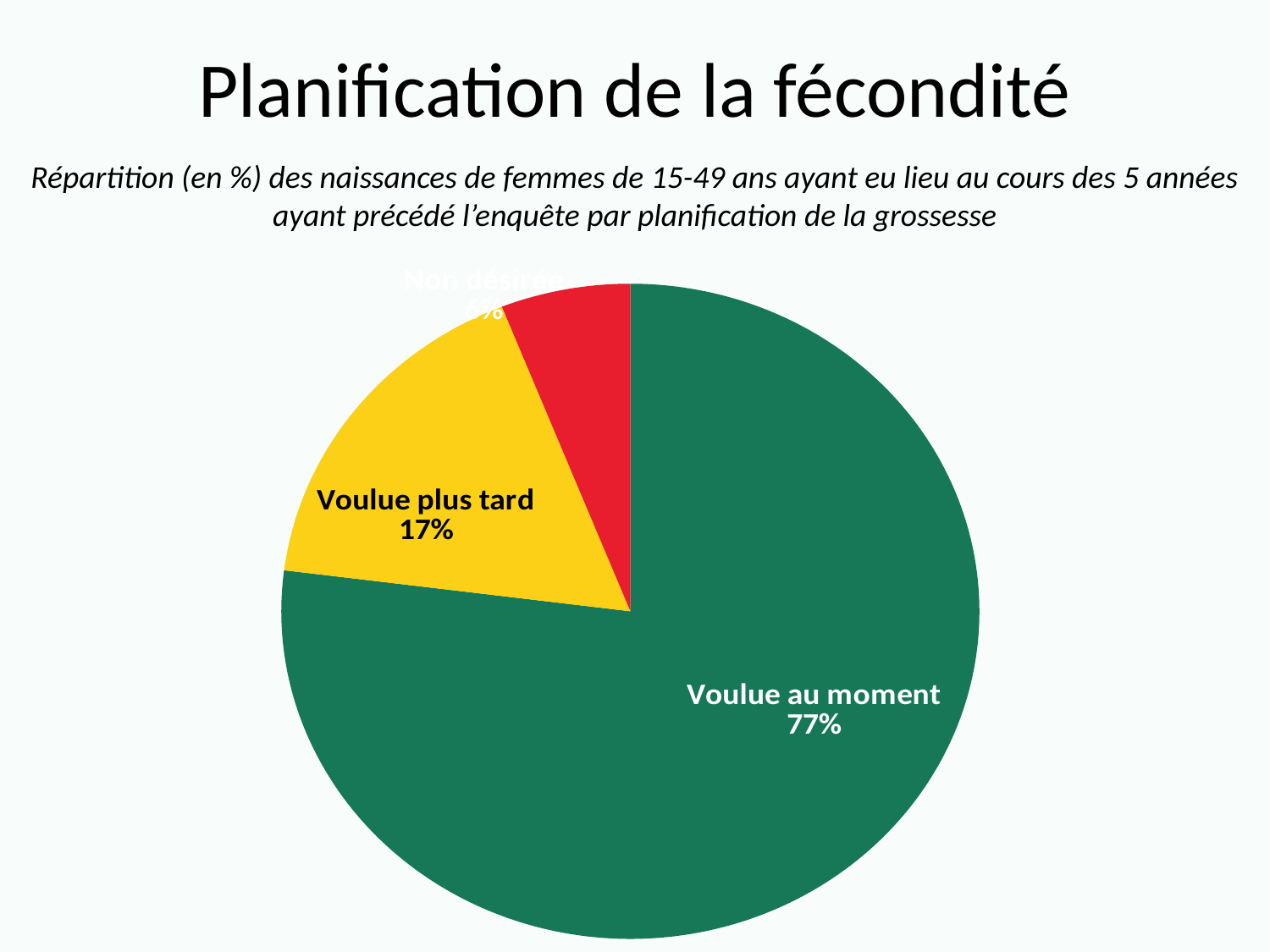
Which category has the smallest share of the pie? Non désirée What is the title of the slide? Planification de la fécondité How many slices does the pie chart have? 3 Which category has the largest share of the pie? Voulue au moment What is the difference in percentage points between 'Voulue au moment' and 'Voulue plus tard'? 60 What percentage of births were 'Voulue au moment'? 77% What percentage of births were 'Voulue plus tard'? 17% What colour is the 'Voulue au moment' slice? green What kind of chart is shown on the slide? pie chart Which is larger, the share for 'Voulue plus tard' or the share for 'Voulue au moment'? Voulue au moment What colour is the 'Voulue plus tard' slice? yellow